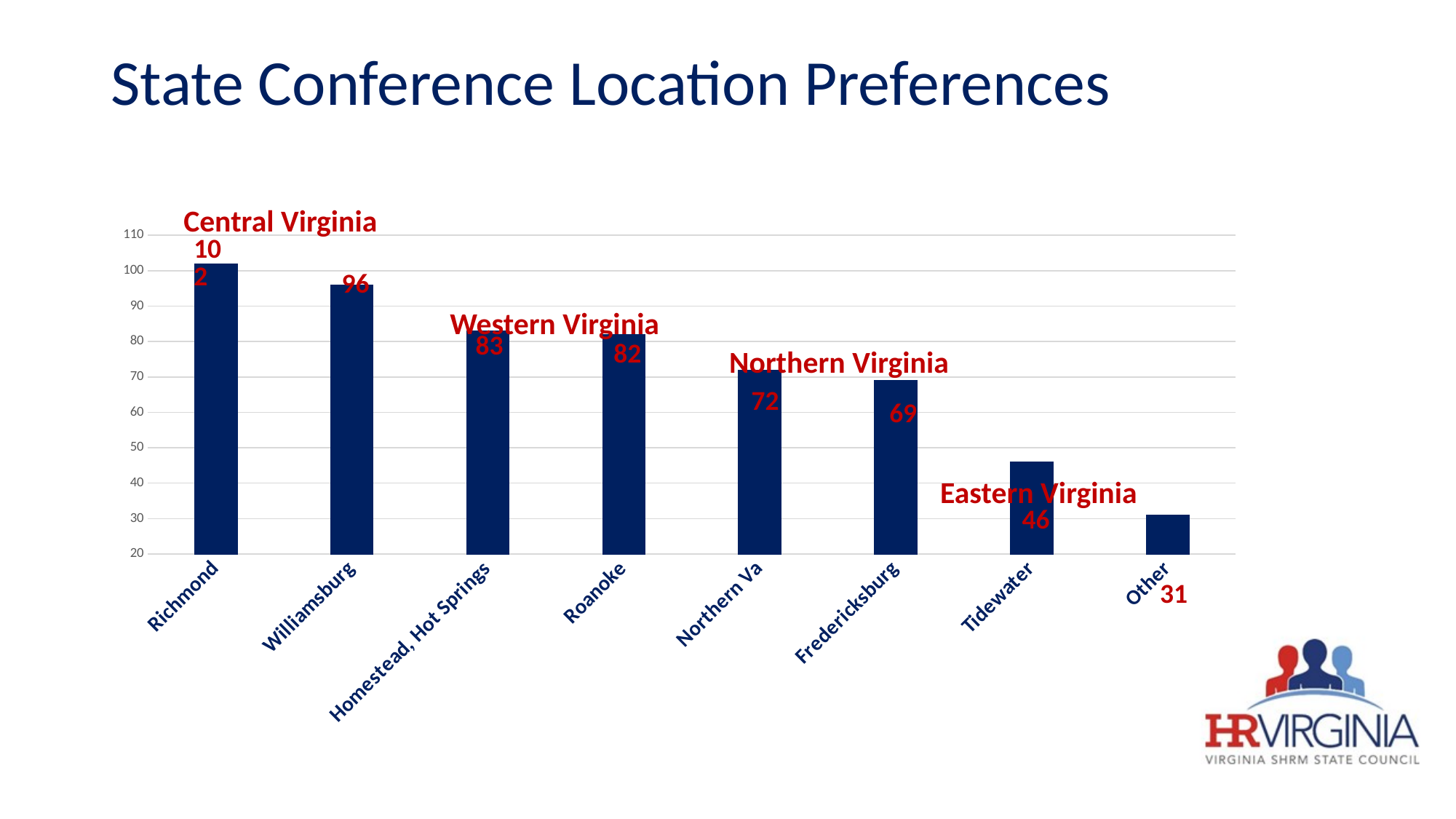
How many locations are shown on the chart? 8 What is the difference between the values for Williamsburg and Roanoke? 14 What is the value for Tidewater? 46 Which has a larger value, Northern Va or Tidewater? Northern Va Which category has the lowest value? Other Which location has the highest value? Richmond What is the value for Other? 31 What is the value for Williamsburg? 96 Do the values rise or fall from left to right across the chart? Fall What kind of chart is shown on the slide? Bar chart What is the value for Northern Va? 72 What is the value for Fredericksburg? 69